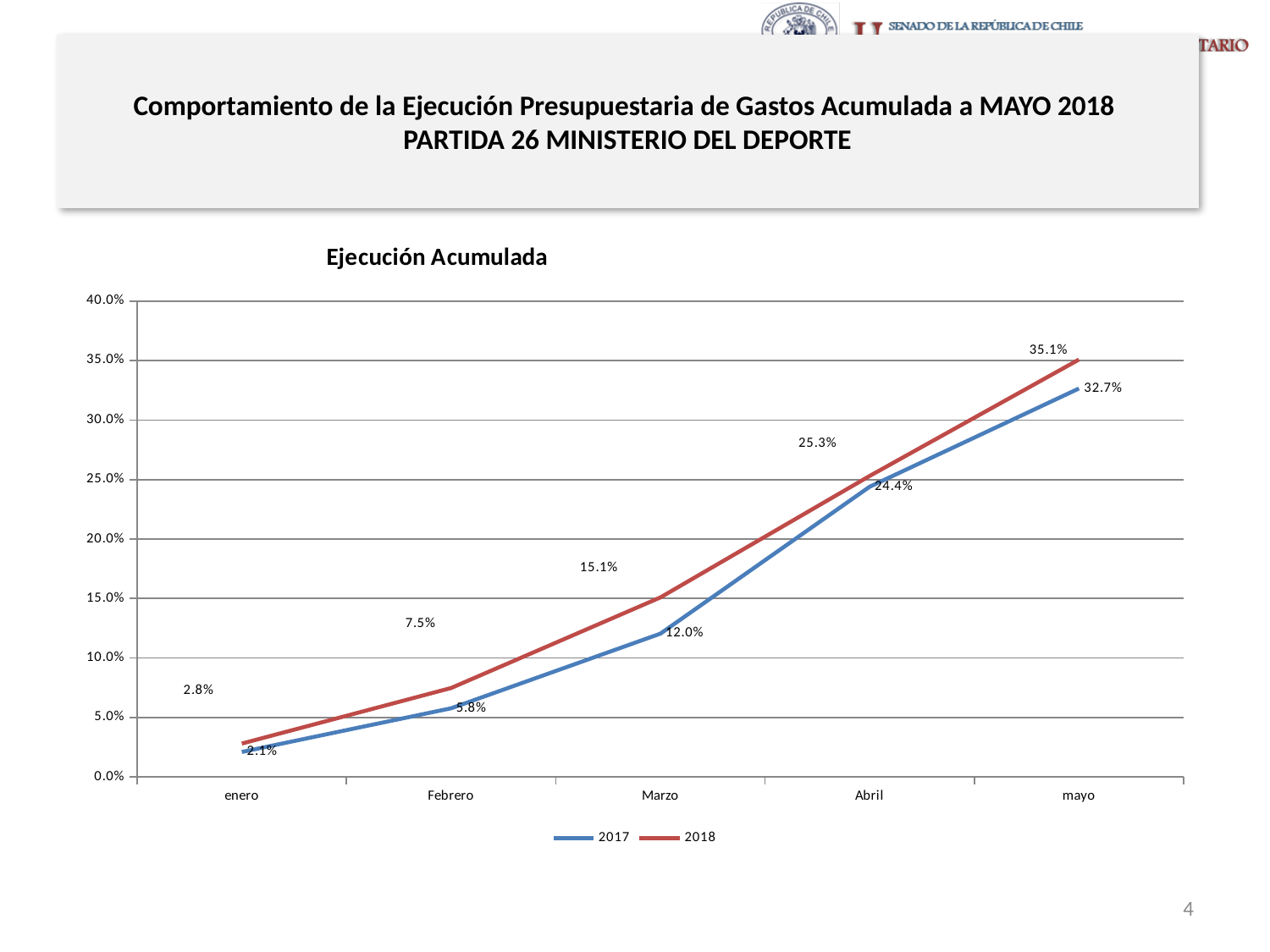
In which month is the 2017 series at its lowest value? enero Which series has the higher value in Marzo, 2017 or 2018? 2018 What is the value for 2017 in enero? 2.1% In which month does the 2018 series reach its highest value? mayo What is the value for 2017 in Marzo? 12.0% How many series does the legend of the "Ejecución Acumulada" chart list? 2 What type of chart is shown under the title "Ejecución Acumulada"? line chart How many months are plotted along the x axis of the "Ejecución Acumulada" chart? 5 What is the difference between the 2018 and 2017 values in mayo? 2.4% What is the value for 2018 in Febrero? 7.5% What is the value for 2018 in mayo? 35.1% Do the values of the 2017 series rise or fall from enero to mayo? rise